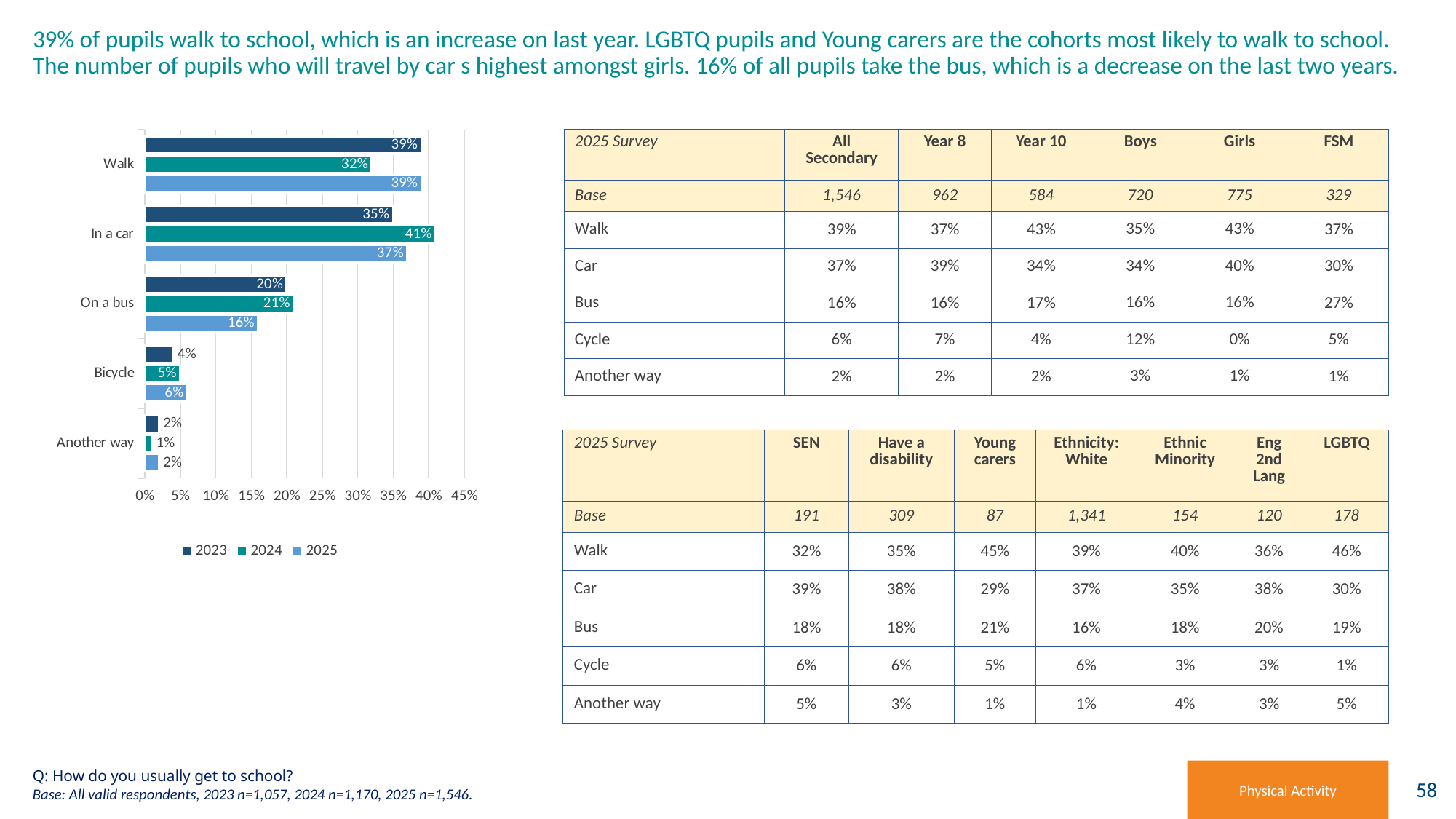
What is the difference between the 2023 and 2025 values for Bicycle in the bar chart? 2% What years are listed in the legend of the bar chart? 2023, 2024, 2025 What is the 2025 value for Walk in the bar chart? 39% How many categories are shown in the bar chart? 5 Which category has the lowest 2025 value in the bar chart? Another way What is the difference between the 2024 and 2025 values for On a bus in the bar chart? 5% Which category has the highest 2024 value in the bar chart? In a car What is the 2024 value for In a car in the bar chart? 41% How many series does the legend of the bar chart list? 3 What kind of chart is shown on the slide? bar chart In the bar chart, is the 2023 value for Walk larger or smaller than the 2024 value for Walk? larger What is the 2023 value for On a bus in the bar chart? 20%